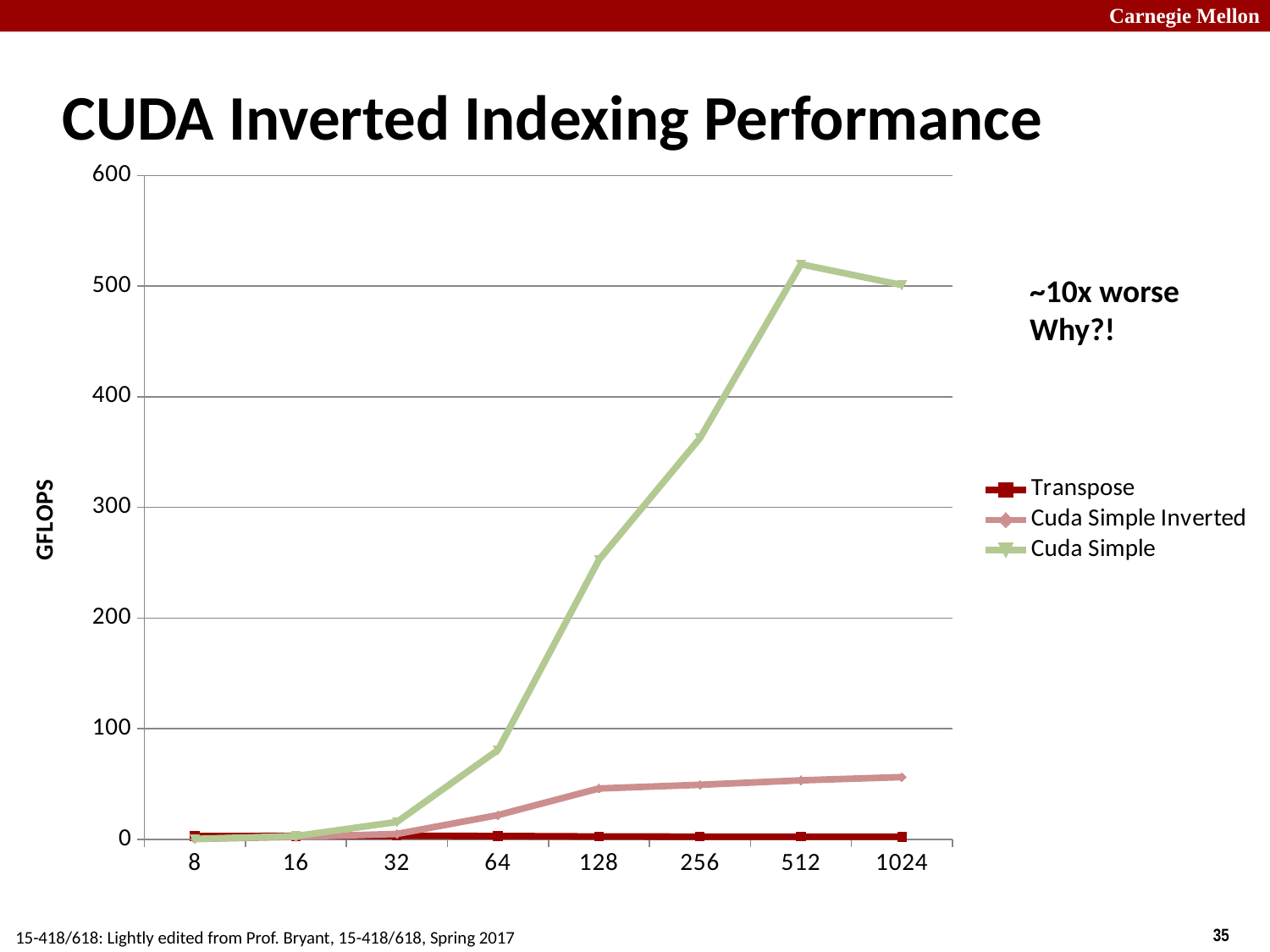
Which series has the lowest GFLOPS values across the chart? Transpose Is the value for Cuda Simple at 512 greater or less than 500? greater Which series reaches the highest GFLOPS value on the chart? Cuda Simple Does the Cuda Simple series generally rise or fall from 8 to 512 along the x axis? rise Is the value for Cuda Simple Inverted at 1024 greater or less than 100? less How many points are plotted along the x axis for each series? 8 What is the label on the y axis of the chart? GFLOPS How many series does the legend list? 3 At 1024, which series has the larger value: Cuda Simple or Cuda Simple Inverted? Cuda Simple Is the value for Cuda Simple at 128 greater or less than 300? less What kind of chart is shown on the slide? line chart